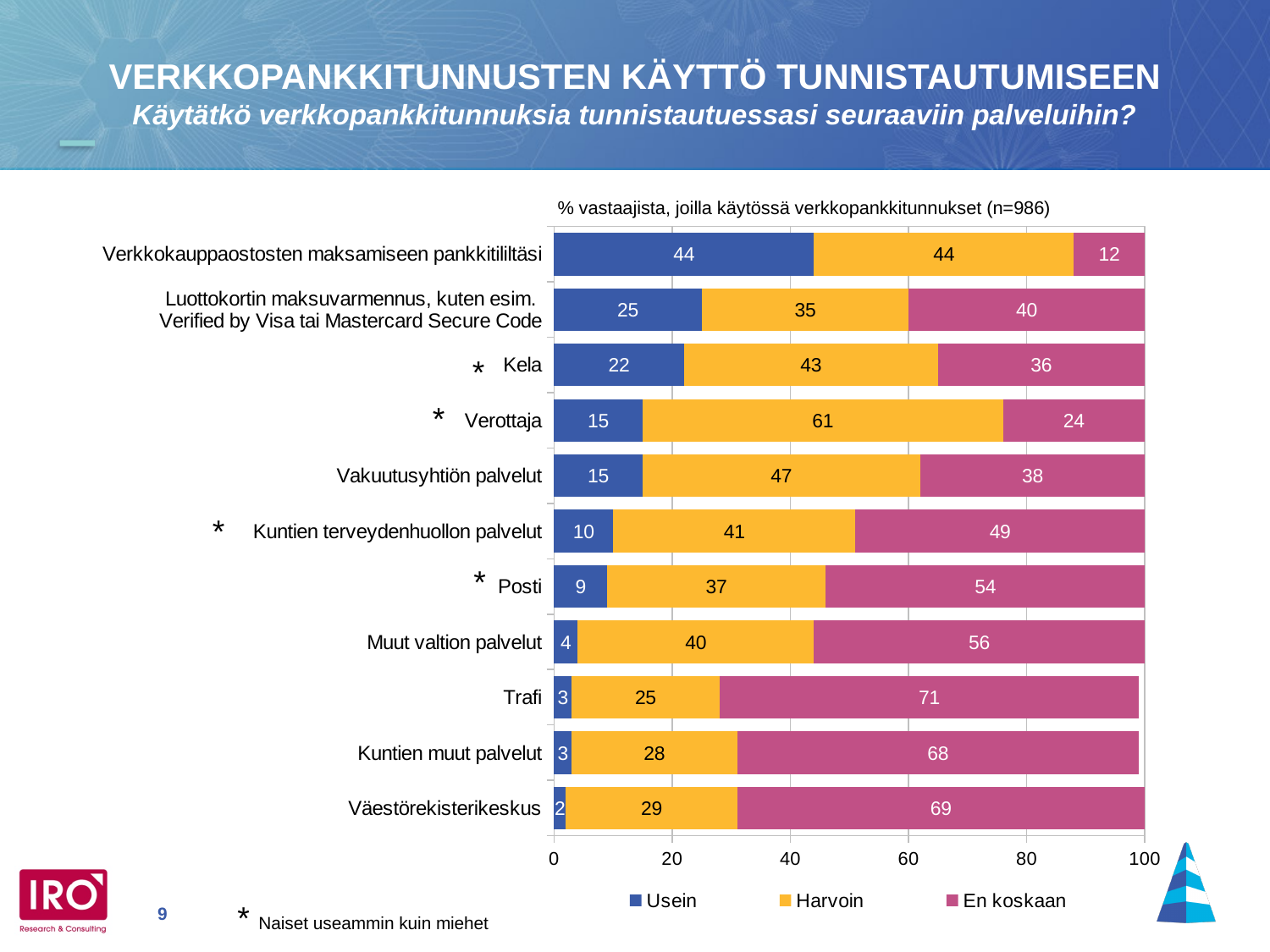
How many categories are shown on the chart? 11 How many series does the legend list? 3 What is the "Usein" value for Väestörekisterikeskus? 2 Which is larger: the "Harvoin" value for Kela or the "Harvoin" value for Posti? Kela What is the "Usein" value for Kela? 22 What kind of chart is shown on the slide? Stacked bar chart Which category has the lowest "En koskaan" value? Verkkokauppaostosten maksamiseen pankkitililtäsi Which category has the highest "Harvoin" value? Verottaja What is the "Harvoin" value for Verottaja? 61 Which category has the highest "Usein" value? Verkkokauppaostosten maksamiseen pankkitililtäsi What is the "En koskaan" value for Trafi? 71 What is the difference between the "En koskaan" values for Trafi and Posti? 17